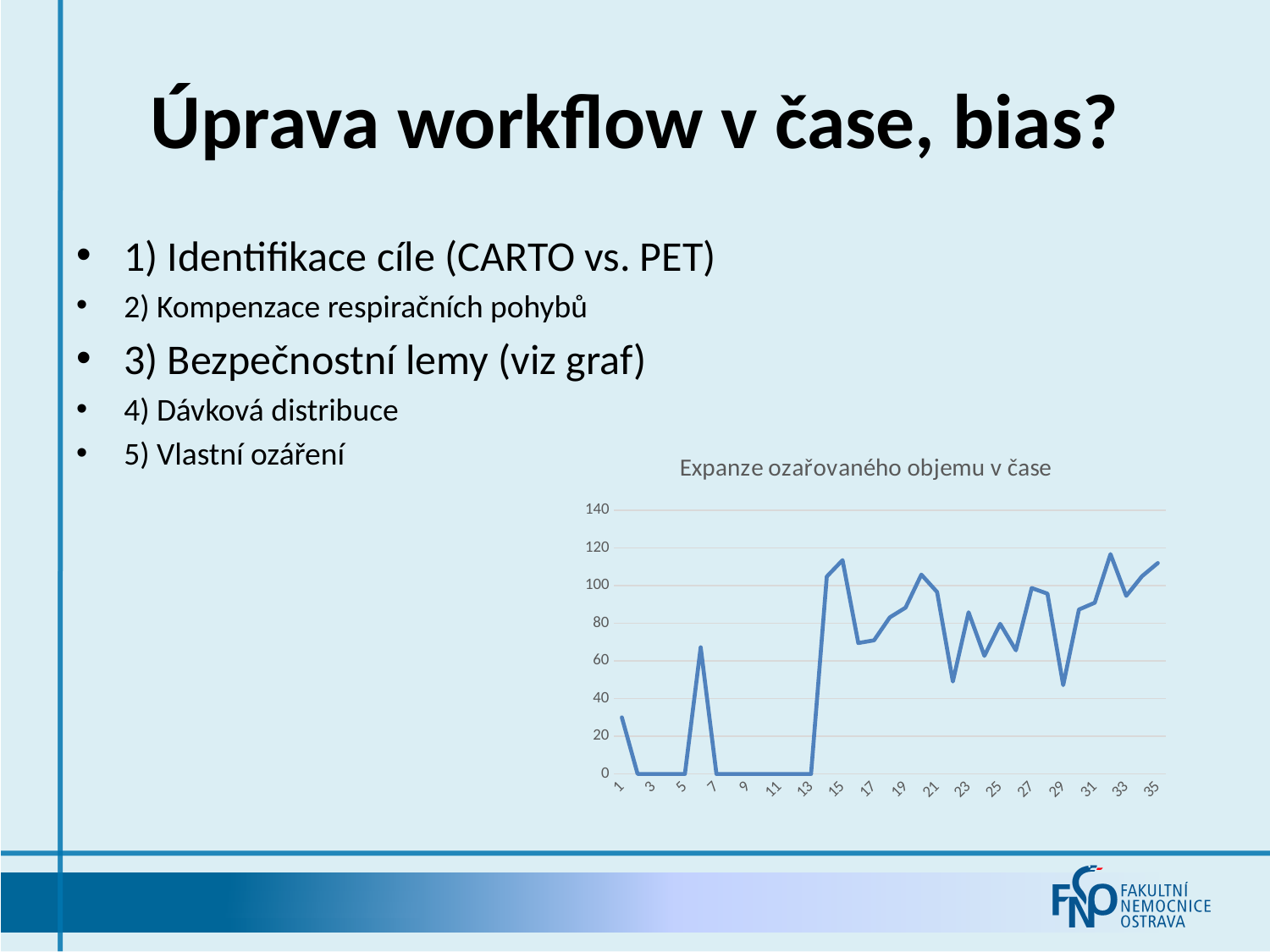
What kind of chart is shown on the slide? line chart What is the value at x = 3 in the chart? 0 What is the title of the chart on the slide? Expanze ozařovaného objemu v čase Is the value at x = 15 greater or less than 100? greater Which is larger, the value at x = 27 or the value at x = 29? x = 27 What is the value at x = 11 in the chart? 0 Is the value at x = 1 greater or less than 40? less Which is larger, the value at x = 1 or the value at x = 15? x = 15 Overall, do the values rise or fall from the start to the end of the x axis? rise Is the value at x = 29 greater or less than 60? less